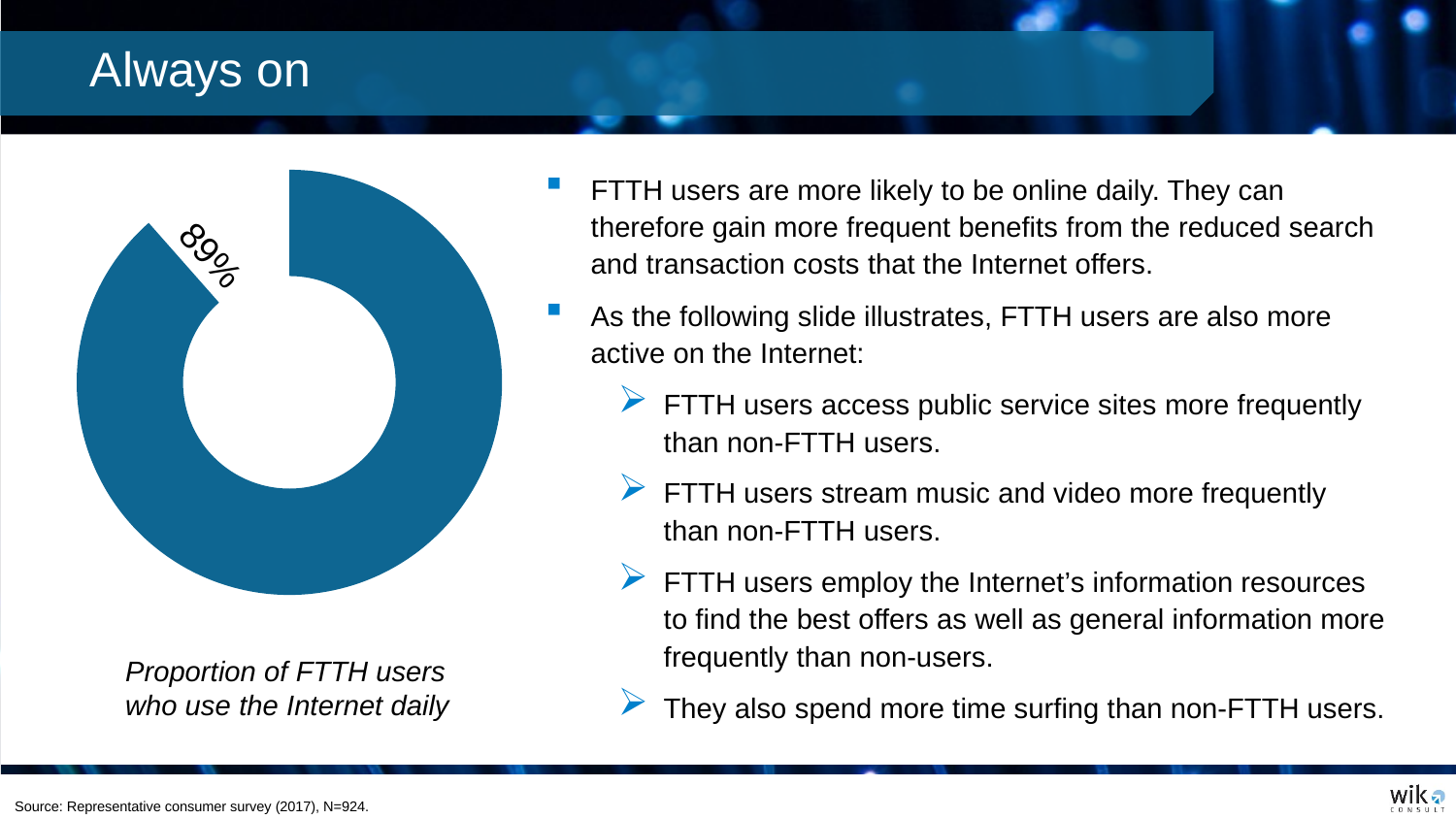
Is the value shown on the doughnut chart greater or less than 90%? less What proportion of FTTH users use the Internet daily, according to the chart? 89% What colour is the labelled segment of the doughnut chart? Blue What share of the doughnut chart does the blue segment represent? 89% What does the caption below the chart say it shows? Proportion of FTTH users who use the Internet daily How many data labels are printed on the doughnut chart? 1 What kind of chart is shown on the left of the slide? Doughnut (pie) chart Is the value shown on the doughnut chart greater or less than 50%? greater